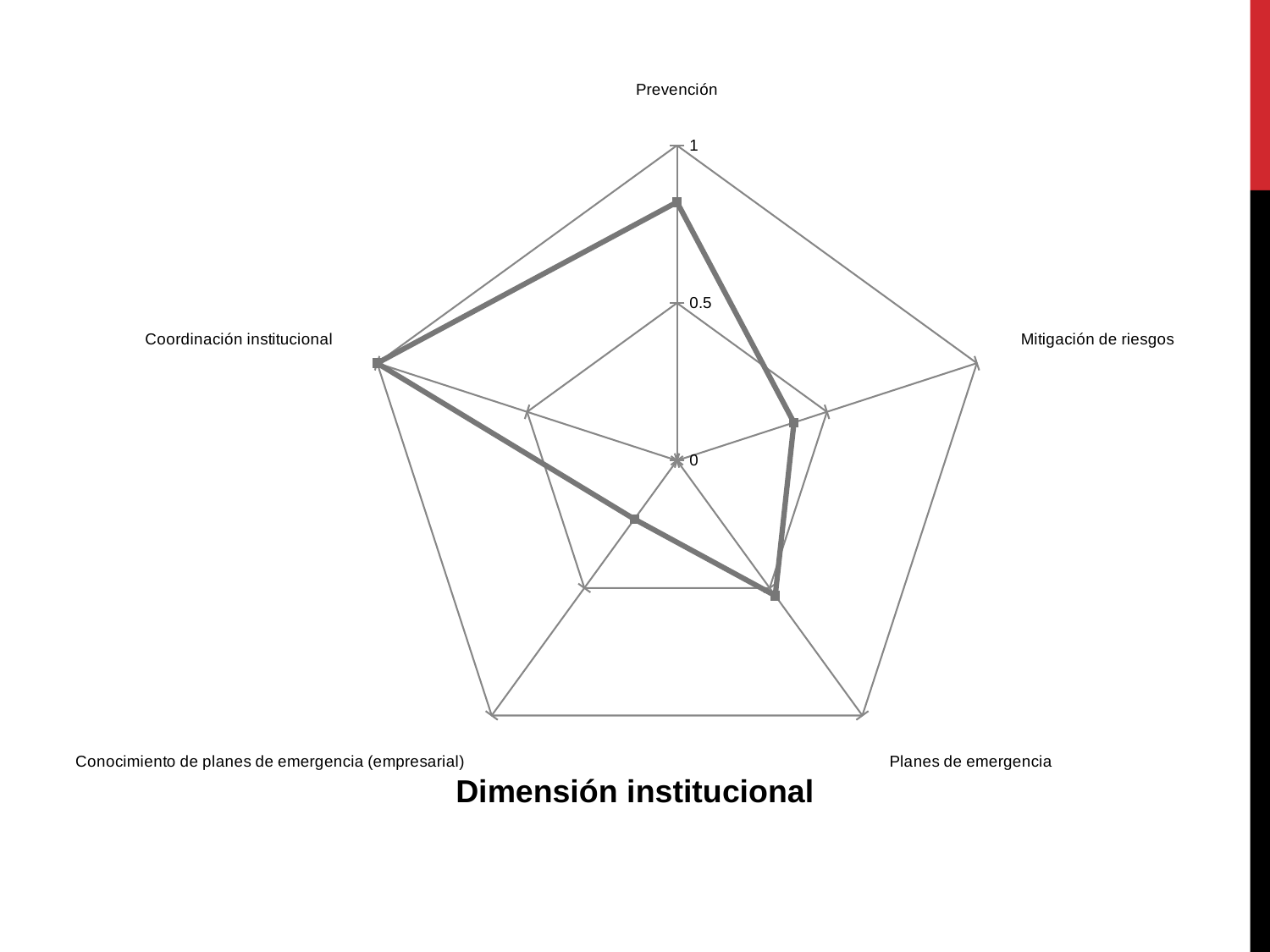
What is the maximum value shown on the chart's axis scale? 1 Is the value for Conocimiento de planes de emergencia (empresarial) greater or less than 0.5? less What kind of chart is shown on the slide? Radar chart Which category has the lowest value? Conocimiento de planes de emergencia (empresarial) Which category has the highest value? Coordinación institucional How many categories (axes) does the radar chart have? 5 Is the value for Prevención greater or less than 0.5? greater What is the title of the chart? Dimensión institucional Is the value for Mitigación de riesgos greater or less than 0.5? less What is the value for Coordinación institucional? 1 Which is larger, the value for Coordinación institucional or the value for Conocimiento de planes de emergencia (empresarial)? Coordinación institucional Which is larger, the value for Prevención or the value for Mitigación de riesgos? Prevención